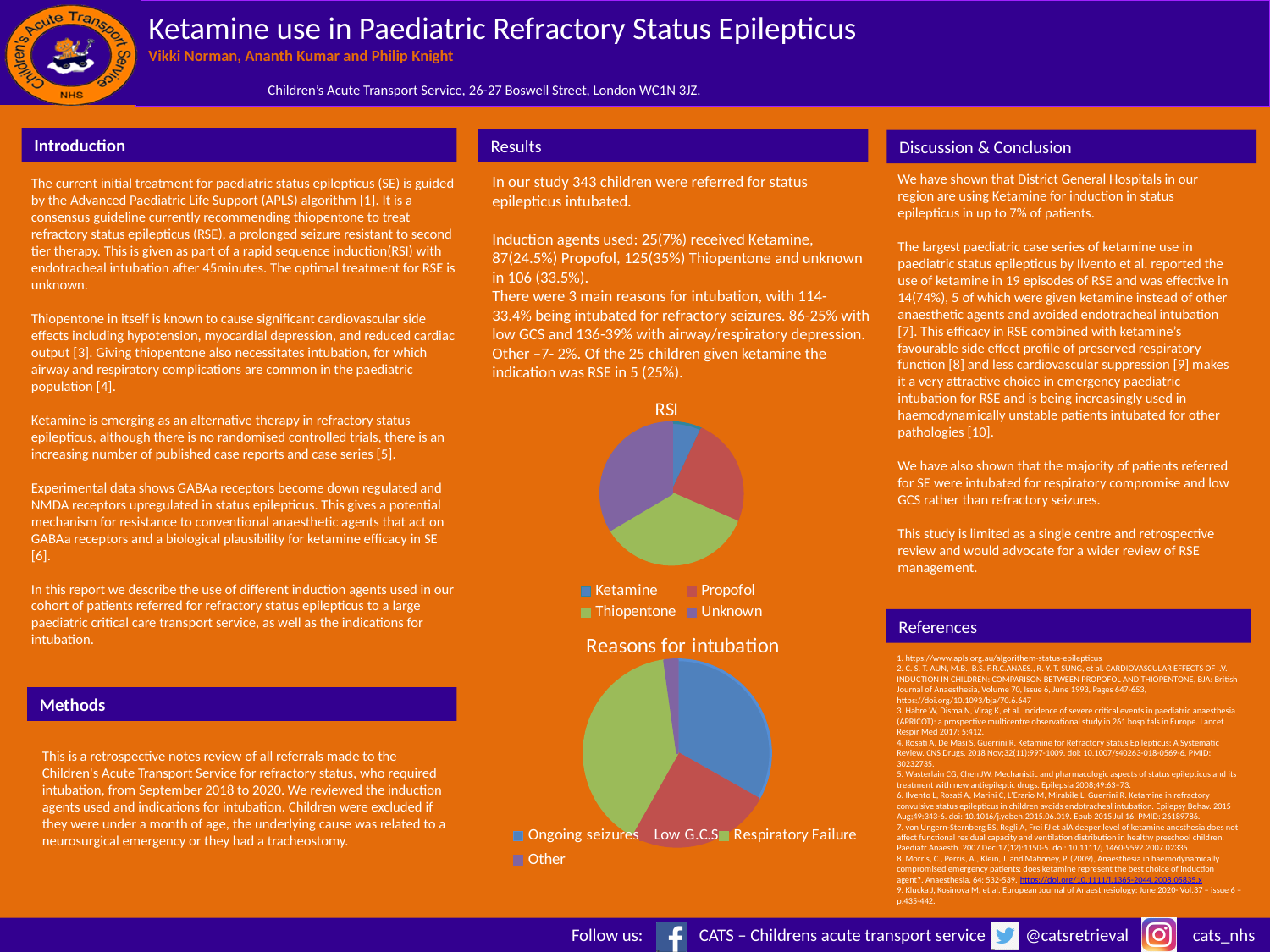
What is the title of the lower pie chart on the slide? Reasons for intubation What kind of chart is the chart titled "RSI"? pie chart What kind of chart is the chart titled "Reasons for intubation"? pie chart In the "Reasons for intubation" chart, which reason has the smallest slice? Other In the "RSI" chart, which induction agent has the smallest slice? Ketamine In the "Reasons for intubation" chart, which slice is larger, Ongoing seizures or Low G.C.S? Ongoing seizures In the "RSI" chart, which slice is larger, Thiopentone or Propofol? Thiopentone In the "Reasons for intubation" chart, which reason has the largest slice? Respiratory Failure In the "Reasons for intubation" chart, how many slices are there? 4 In the "RSI" chart, which slice is larger, Propofol or Ketamine? Propofol In the "RSI" chart, how many categories does the legend list? 4 In the "RSI" chart, what colour is the Thiopentone slice? green